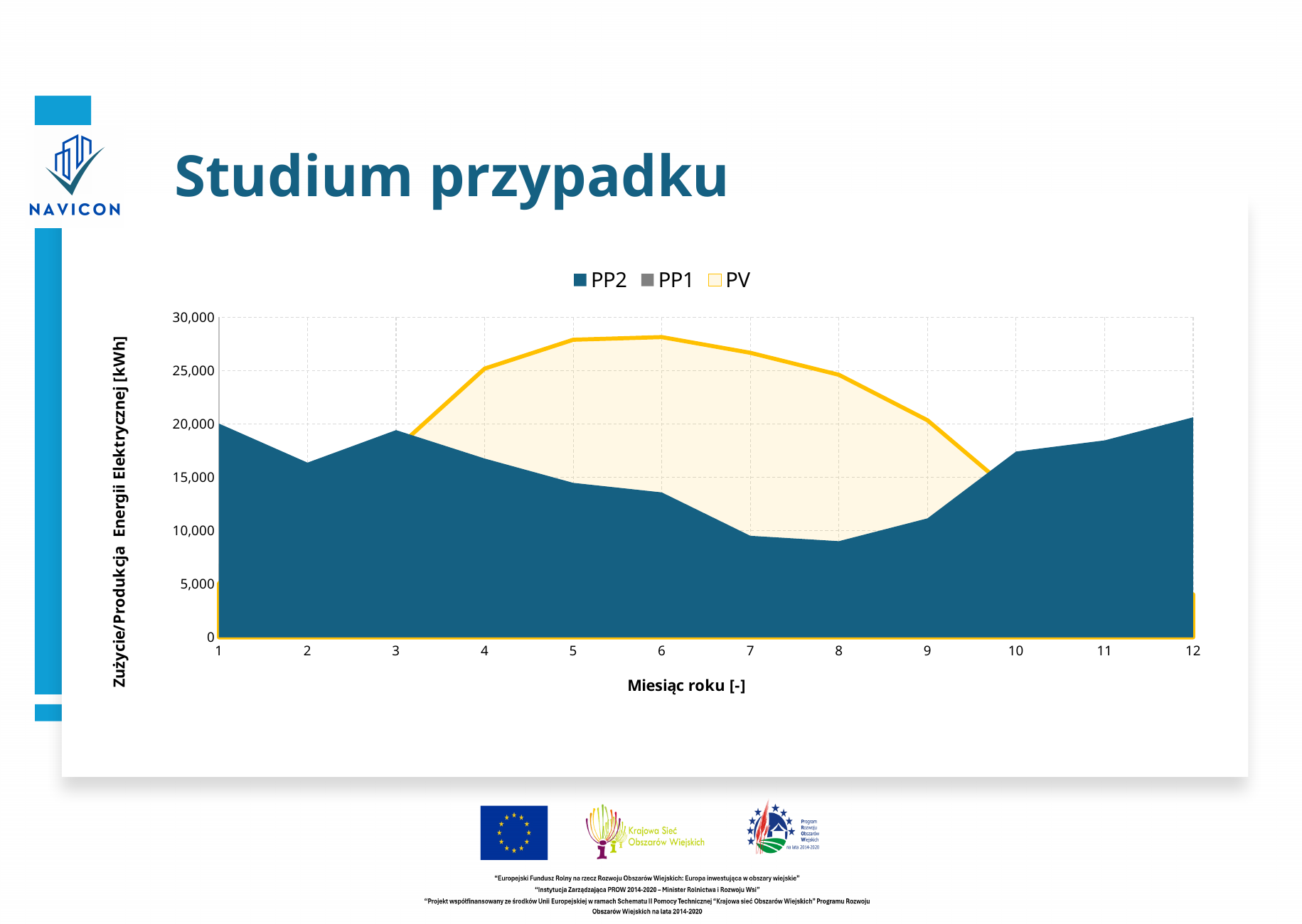
What is the title of the x axis? Miesiąc roku [-] Is the PP2 value for month 8 greater or less than 10,000? less Which series are listed in the legend? PP2, PP1, PV For PP2, which month has the larger value, month 1 or month 2? month 1 What kind of chart is shown on the slide? area chart How many series does the legend list? 3 Is the PP2 value for month 2 greater or less than 15,000? greater At month 6, which series has the larger value, PV or PP2? PV How many months are plotted along the x axis? 12 Does the PP2 series rise or fall from month 3 to month 8? fall Is the PV value for month 9 greater or less than 15,000? greater